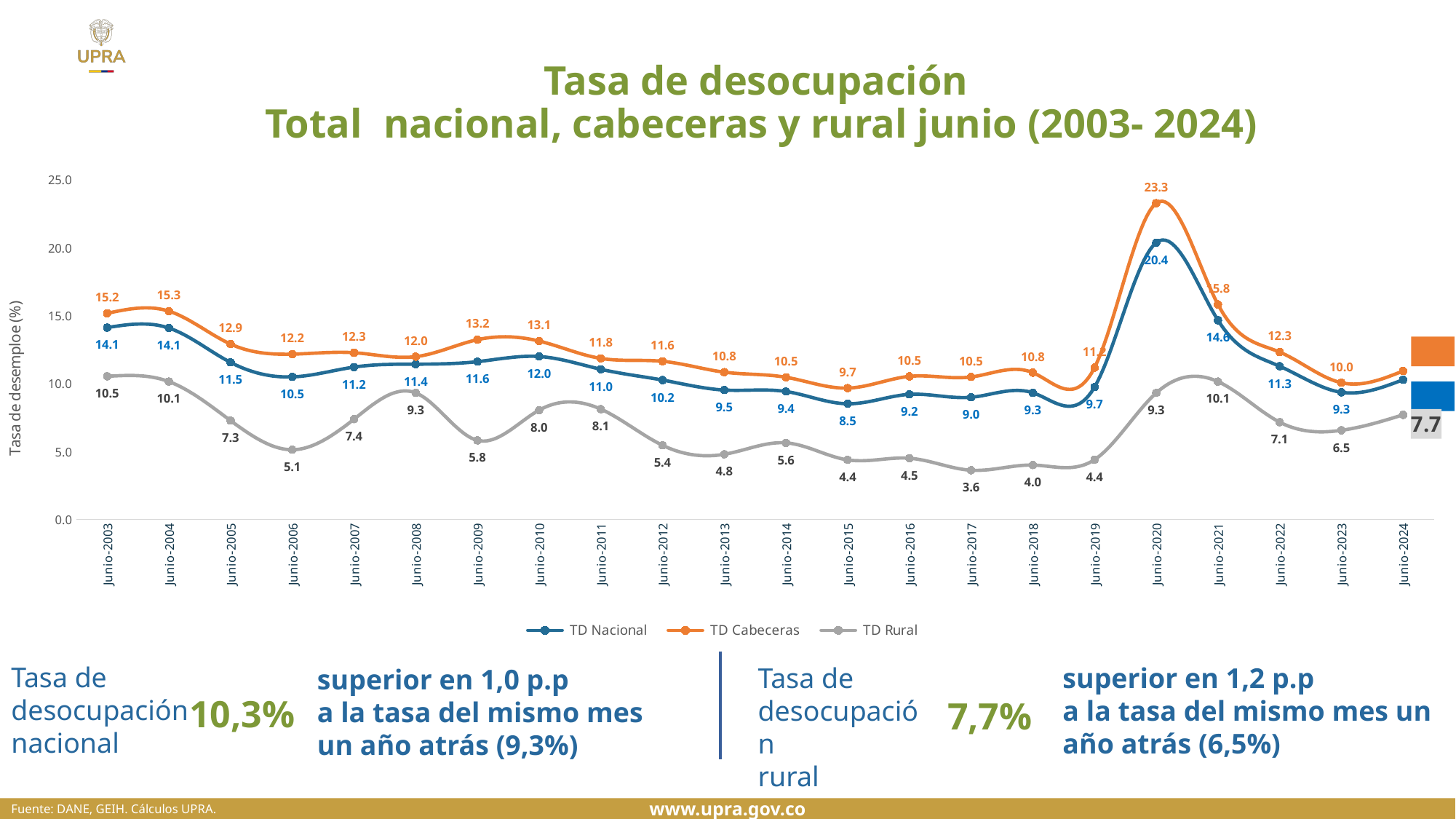
Does TD Cabeceras rise or fall from Junio-2020 to Junio-2023? fall Which is larger for TD Rural: the value for Junio-2008 or the value for Junio-2009? Junio-2008 What is the value of TD Rural for Junio-2017? 3.6 What kind of chart is shown on the slide? line chart What is the difference between TD Cabeceras and TD Nacional in Junio-2020? 2.9 What is the value of TD Cabeceras for Junio-2020? 23.3 How many series does the legend list? 3 What is the value of TD Nacional for Junio-2015? 8.5 Is the value of TD Cabeceras for Junio-2020 greater or less than 20.0? greater How many time points are plotted along the x axis? 22 In which period does TD Rural reach its lowest value? Junio-2017 In which period does TD Nacional reach its highest value? Junio-2020